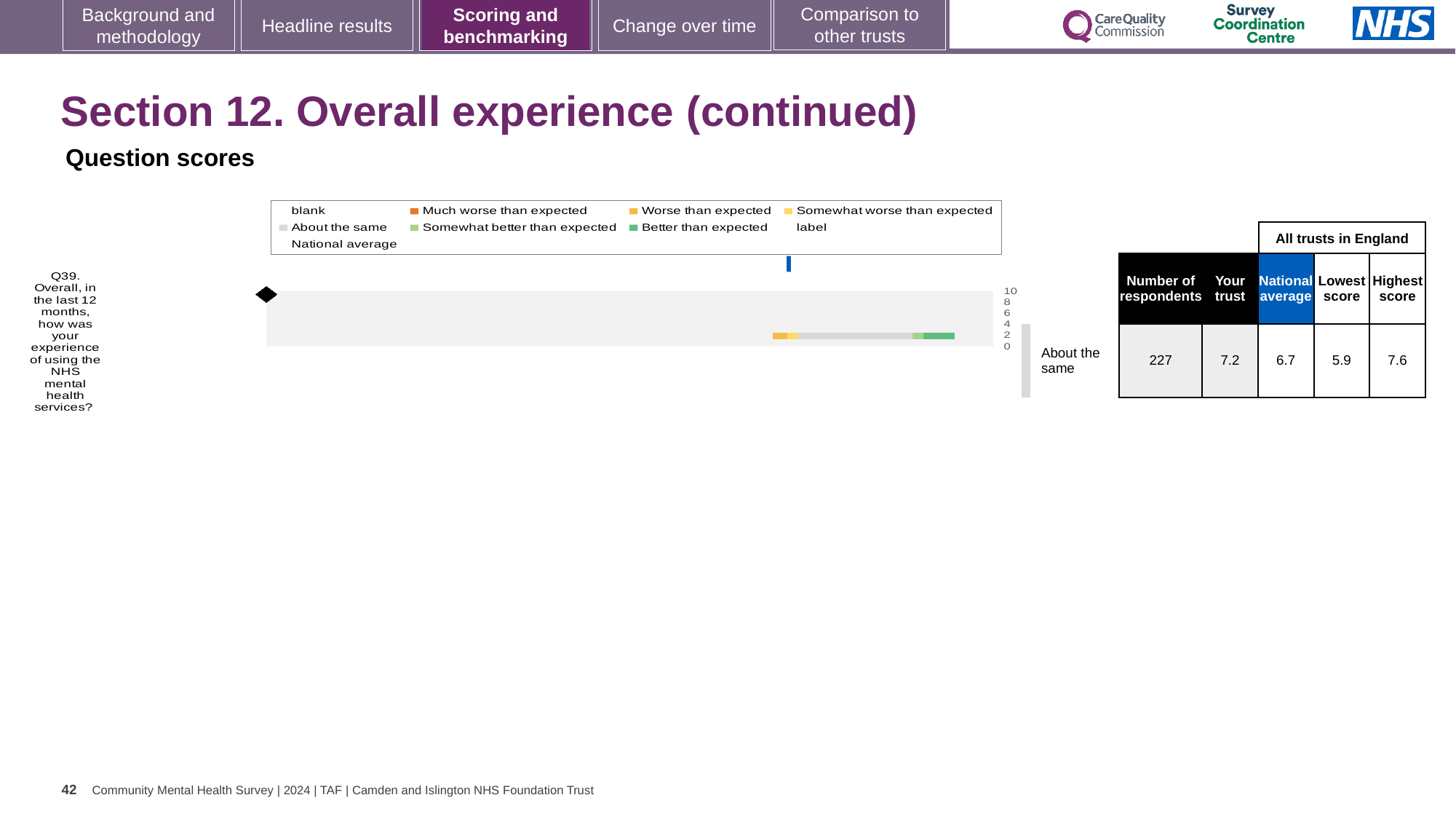
How many respondents answered Q39? 227 Is the trust's score for Q39 greater or less than 6 on the chart axis? greater How many survey questions are plotted in the chart on this slide? 1 What kind of chart is shown for Q39 on the slide? bar chart What is the 'Your trust' score for Q39? 7.2 Which benchmarking category is the trust's Q39 score placed in, according to the label beside the chart? About the same What is the highest score among all trusts in England for Q39? 7.6 What is the national average score for Q39? 6.7 Which is higher for Q39: the trust's score or the national average? Your trust By how much does the trust's score for Q39 exceed the national average? 0.5 What is the difference between the highest and lowest scores for Q39 across all trusts in England? 1.7 What is the lowest score among all trusts in England for Q39? 5.9